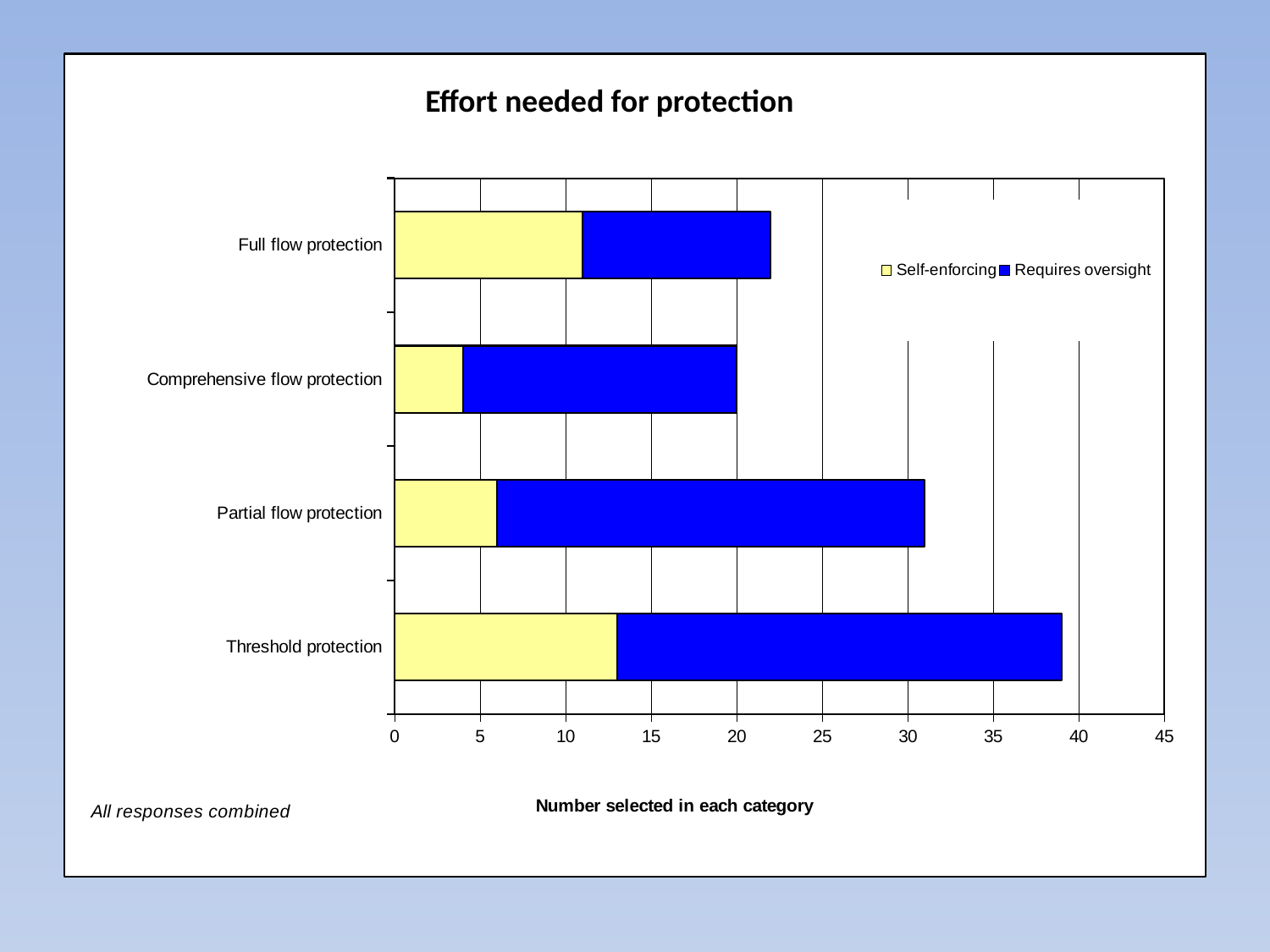
Is the Self-enforcing value for Threshold protection greater or less than 10? greater Which category has the smallest Self-enforcing value? Comprehensive flow protection How many categories are shown on the chart? 4 Which has the longer total bar, Partial flow protection or Full flow protection? Partial flow protection Is the total bar for Threshold protection greater or less than 35? greater Is the Self-enforcing value for Comprehensive flow protection greater or less than 5? less Which category has the longest total bar? Threshold protection What is the title of the chart? Effort needed for protection How many series does the legend list? 2 What is the label of the horizontal axis? Number selected in each category What kind of chart is shown on the slide? Stacked bar chart